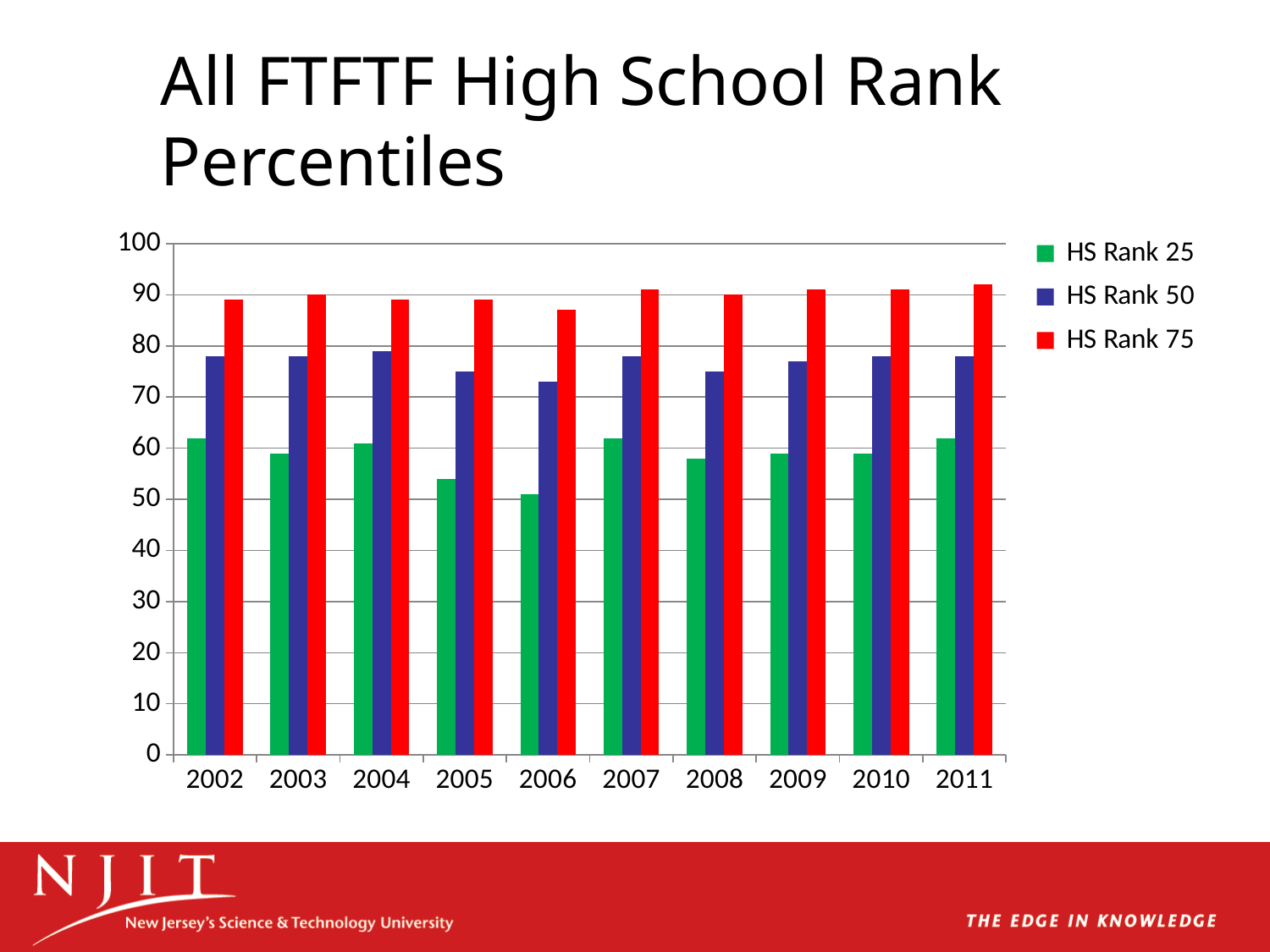
Which is larger, the HS Rank 25 value for 2002 or for 2006? 2002 Is the value for HS Rank 75 in 2002 greater or less than 80? greater Is the value for HS Rank 50 in 2005 greater or less than 70? greater Which year has the lowest value for HS Rank 25? 2006 How many years are shown on the x axis? 10 Is the value for HS Rank 25 in 2005 greater or less than 60? less Which year has the lowest value for HS Rank 75? 2006 Which is larger, the HS Rank 50 value for 2004 or for 2006? 2004 How many series does the legend list? 3 Which colour represents HS Rank 75 in the legend? red What kind of chart is shown on the slide? bar chart